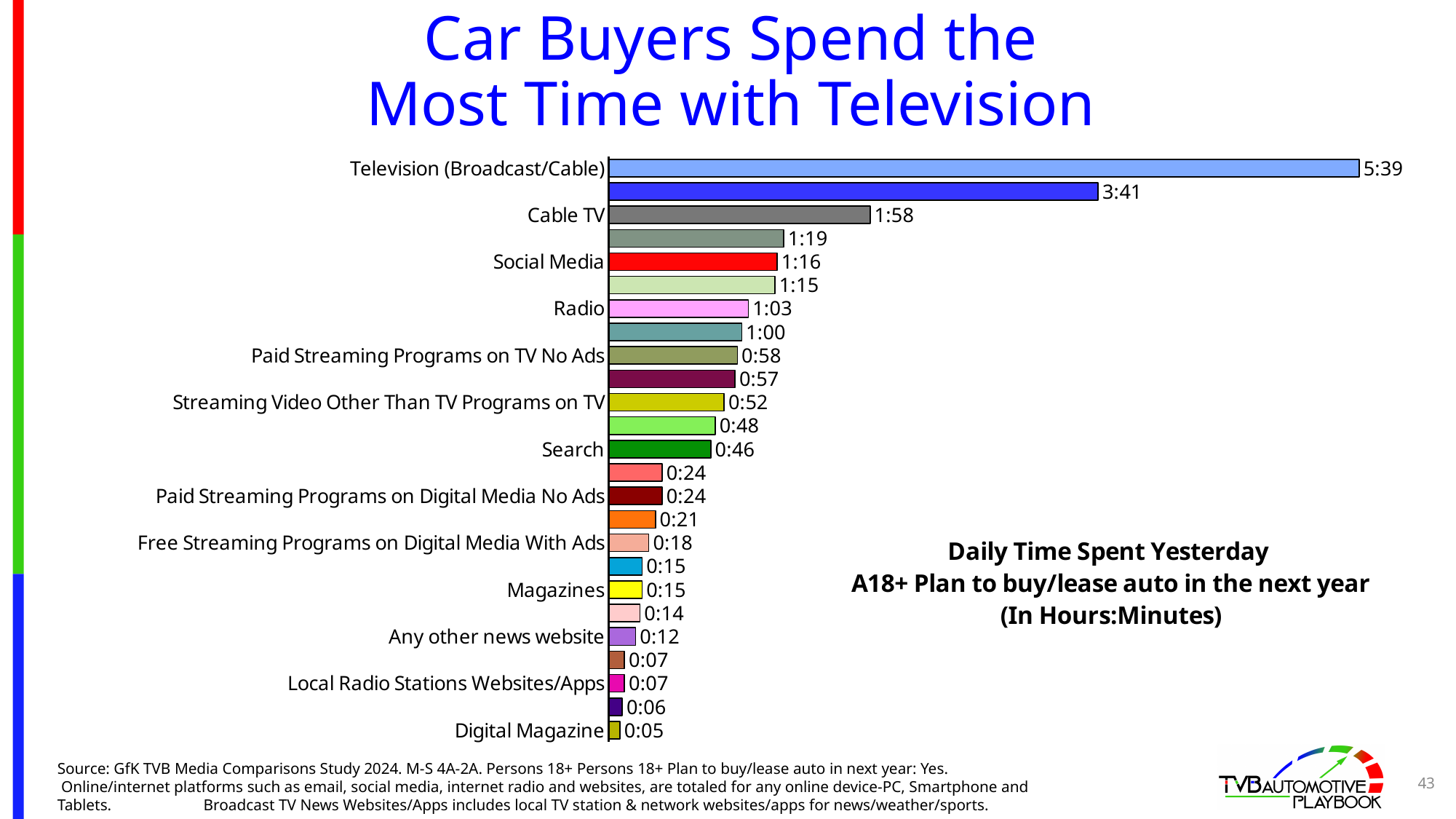
How many bars are plotted in the chart? 25 What is the daily time spent with Television (Broadcast/Cable)? 5:39 What is the daily time spent with Cable TV? 1:58 What is the daily time spent with Search? 0:46 What is the daily time spent with Social Media? 1:16 Which category has the highest daily time spent? Television (Broadcast/Cable) What type of chart is shown on the slide? Bar chart What is the daily time spent with Radio? 1:03 How much more daily time is spent with Television (Broadcast/Cable) than with Cable TV? 3:41 What is the daily time spent with Digital Magazine? 0:05 Which has a larger daily time spent, Social Media or Radio? Social Media Which category has the lowest daily time spent? Digital Magazine